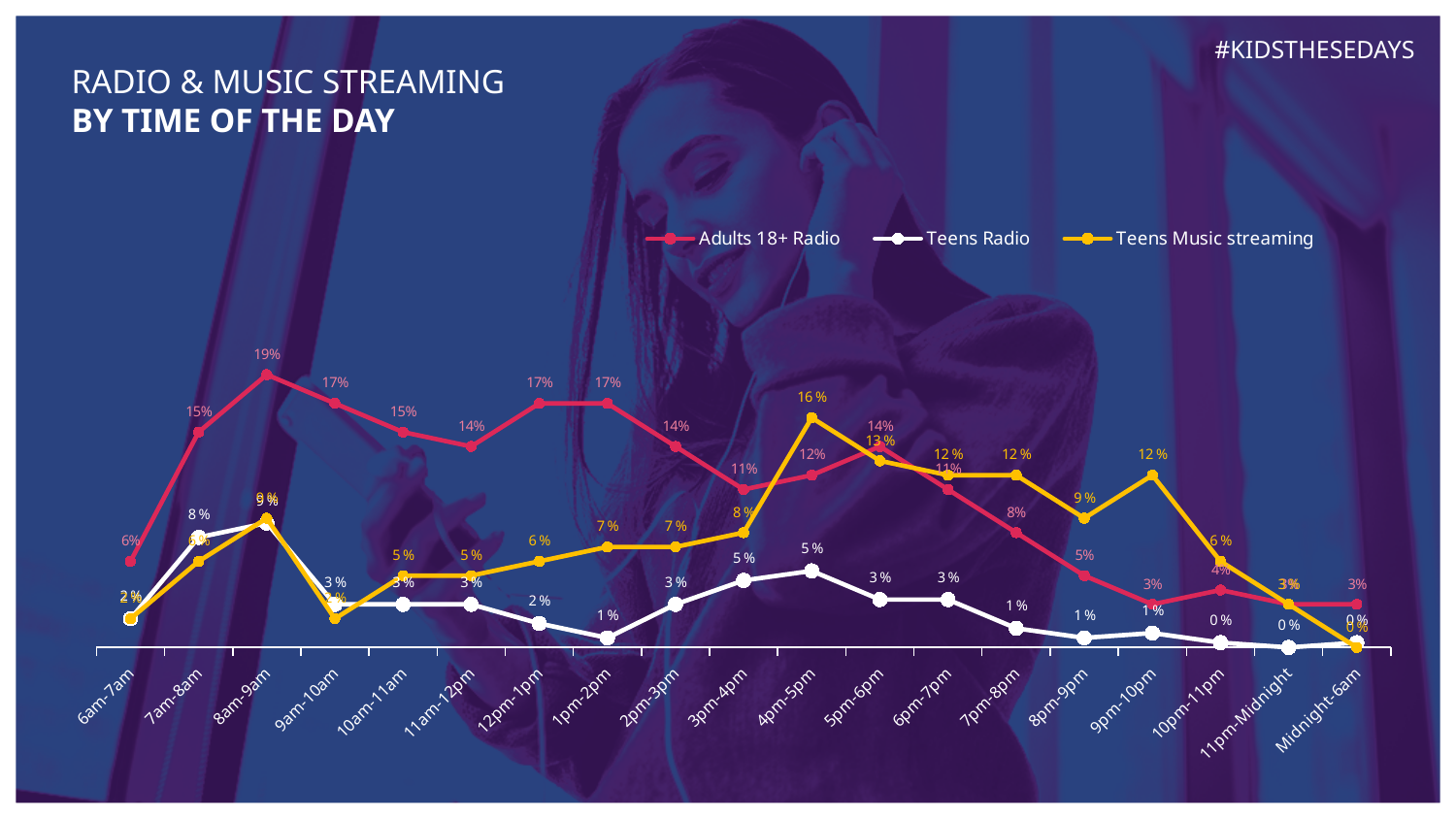
In the 4pm-5pm slot, which is larger: Adults 18+ Radio or Teens Music streaming? Teens Music streaming What is the value for Teens Music streaming in the 4pm-5pm slot? 16 % How many series does the legend list? 3 What colour is the Teens Radio line in the legend? White In which time slot does the Adults 18+ Radio series reach its highest value? 8am-9am What is the difference between Adults 18+ Radio and Teens Radio in the 8am-9am slot? 10 percentage points What is the value for Teens Radio in the 3pm-4pm slot? 5 % What kind of chart is shown on the slide? Line chart What is the value for Adults 18+ Radio in the 6am-7am slot? 6% How many time-of-day categories are plotted along the x axis? 19 In which time slot does Teens Music streaming reach its highest value? 4pm-5pm Does the Adults 18+ Radio series rise or fall from 5pm-6pm to 9pm-10pm? Fall